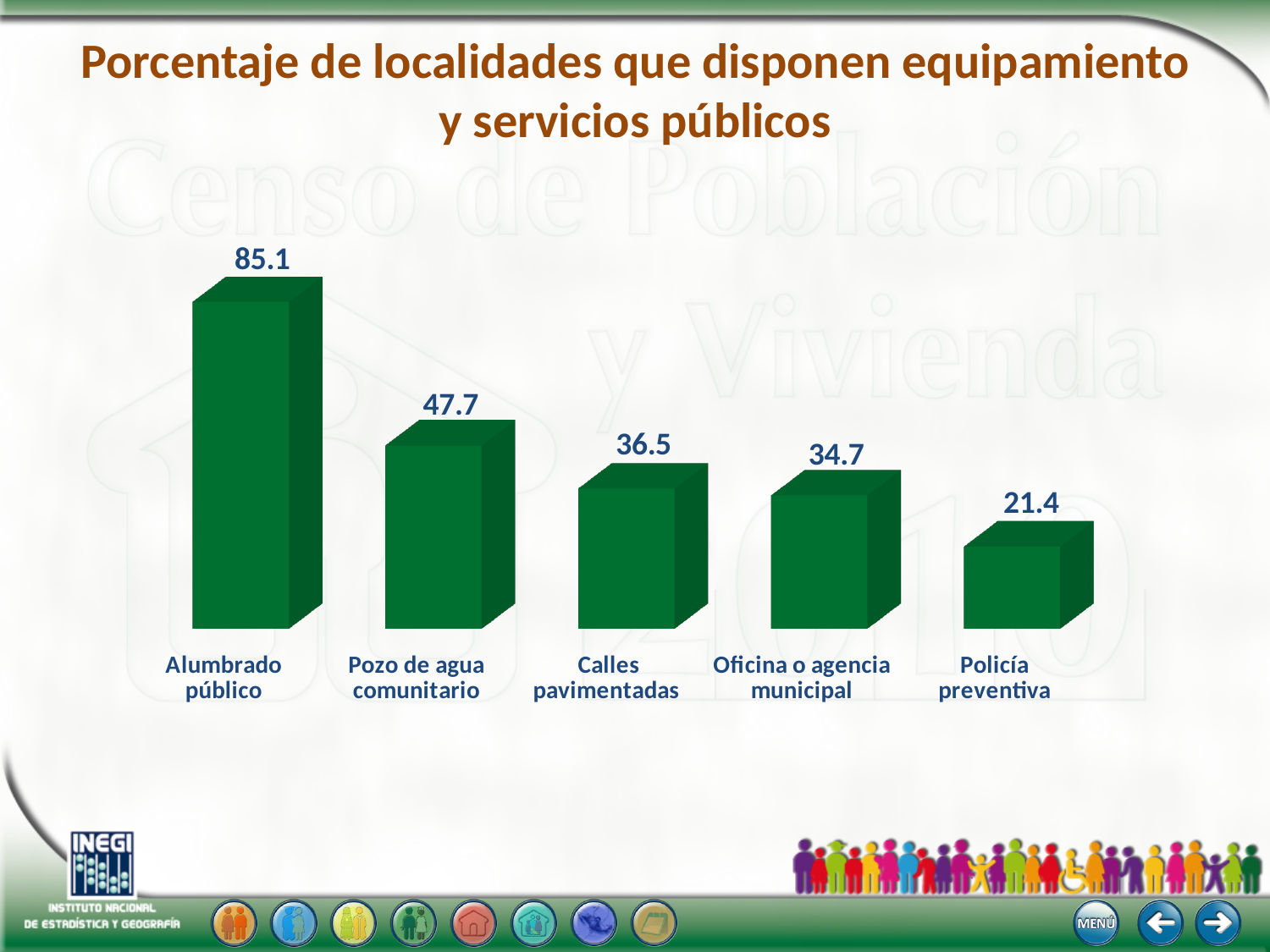
Do the values rise or fall from left to right along the x axis? Fall What is the value for Calles pavimentadas? 36.5 What is the value for Alumbrado público? 85.1 Which category has the highest value? Alumbrado público What kind of chart is shown on the slide? Bar chart What is the value for Pozo de agua comunitario? 47.7 What is the value for Policía preventiva? 21.4 Which category has the lowest value? Policía preventiva Which is larger, the value for Pozo de agua comunitario or the value for Policía preventiva? Pozo de agua comunitario How many categories are shown in the chart? 5 What is the difference between the values for Calles pavimentadas and Oficina o agencia municipal? 1.8 What is the difference between the values for Alumbrado público and Pozo de agua comunitario? 37.4